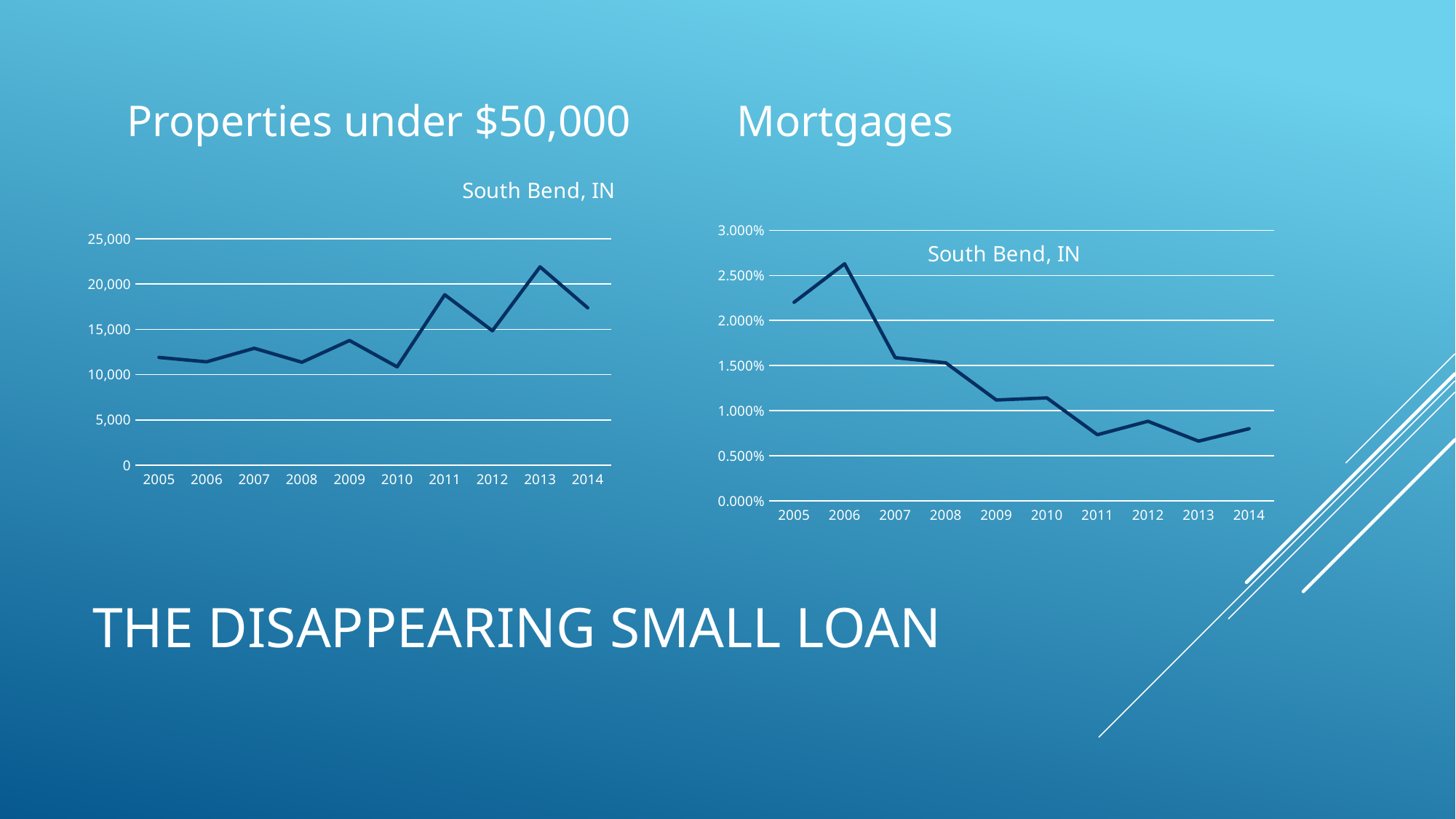
What kind of chart is the 'Mortgages' chart on the right? line chart In the 'Properties under $50,000' chart, is the value for 2009 greater or less than 15,000? less In the 'Mortgages' chart, is the value for 2013 greater or less than 1.000%? less In the 'Mortgages' chart, is the value for 2006 greater or less than 2.500%? greater In the 'Mortgages' chart, which is larger, the value for 2005 or the value for 2009? 2005 Which city do both charts on the slide refer to? South Bend, IN In the 'Properties under $50,000' chart, how many years are shown on the x axis? 10 In the 'Mortgages' chart, do the values generally rise or fall from 2005 to 2014? fall In the 'Mortgages' chart, which year has the highest value? 2006 In the 'Properties under $50,000' chart, which year has the highest value? 2013 What kind of chart is the 'Properties under $50,000' chart on the left? line chart